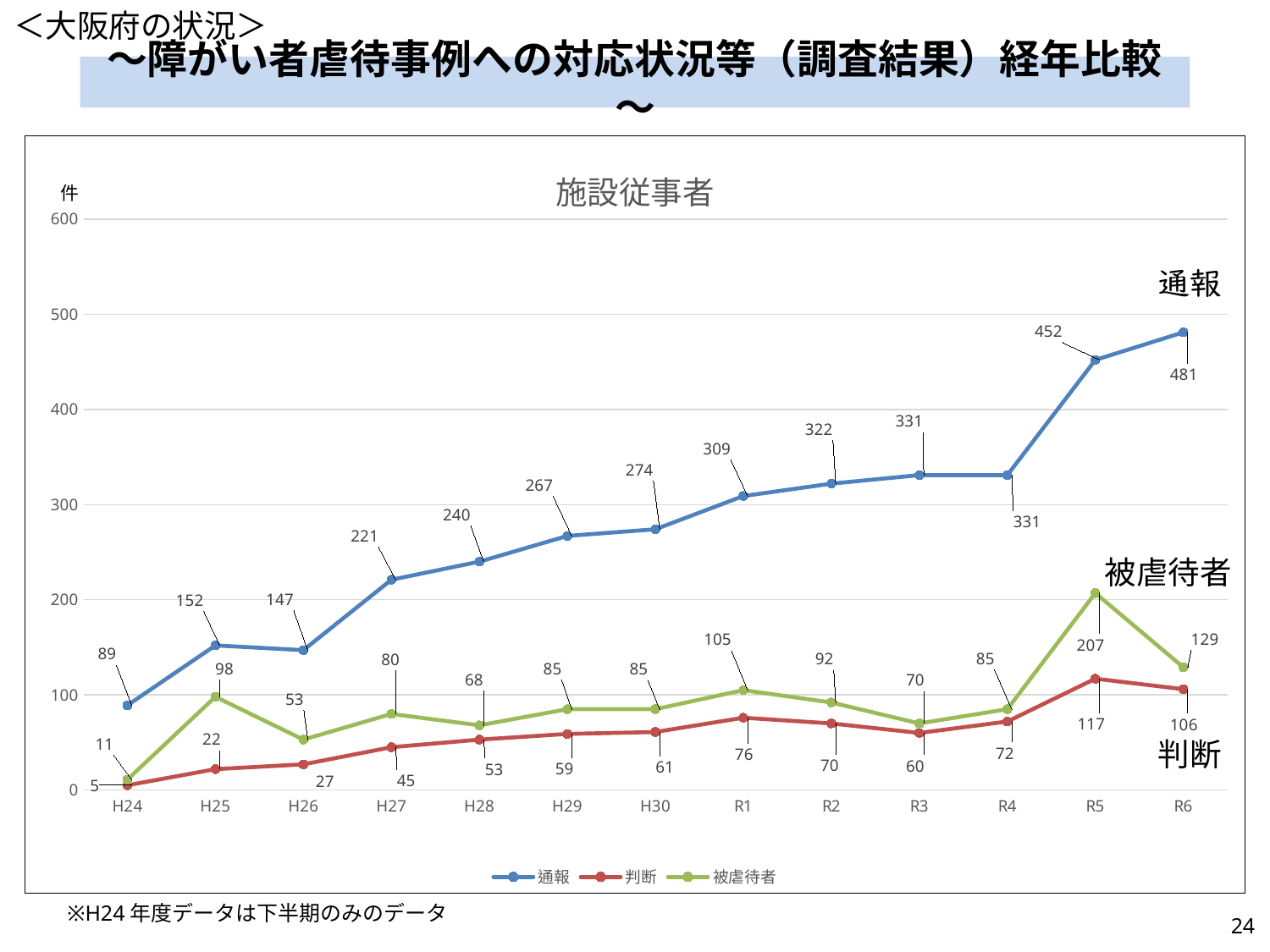
In which year is 判断 lowest? H24 Which is larger, 被虐待者 in H25 or 被虐待者 in H26? H25 What is the value of 判断 for H28? 53 How many years are shown on the x axis? 13 What is the value of 被虐待者 for R5? 207 What is the value of 通報 for R6? 481 In which year is 通報 highest? R6 What is the difference between 通報 in R5 and R4? 121 What is the title of the chart? 施設従事者 How many series does the legend list? 3 Does 通報 generally rise or fall from H24 to R6? rise What type of chart is shown on the slide? line chart